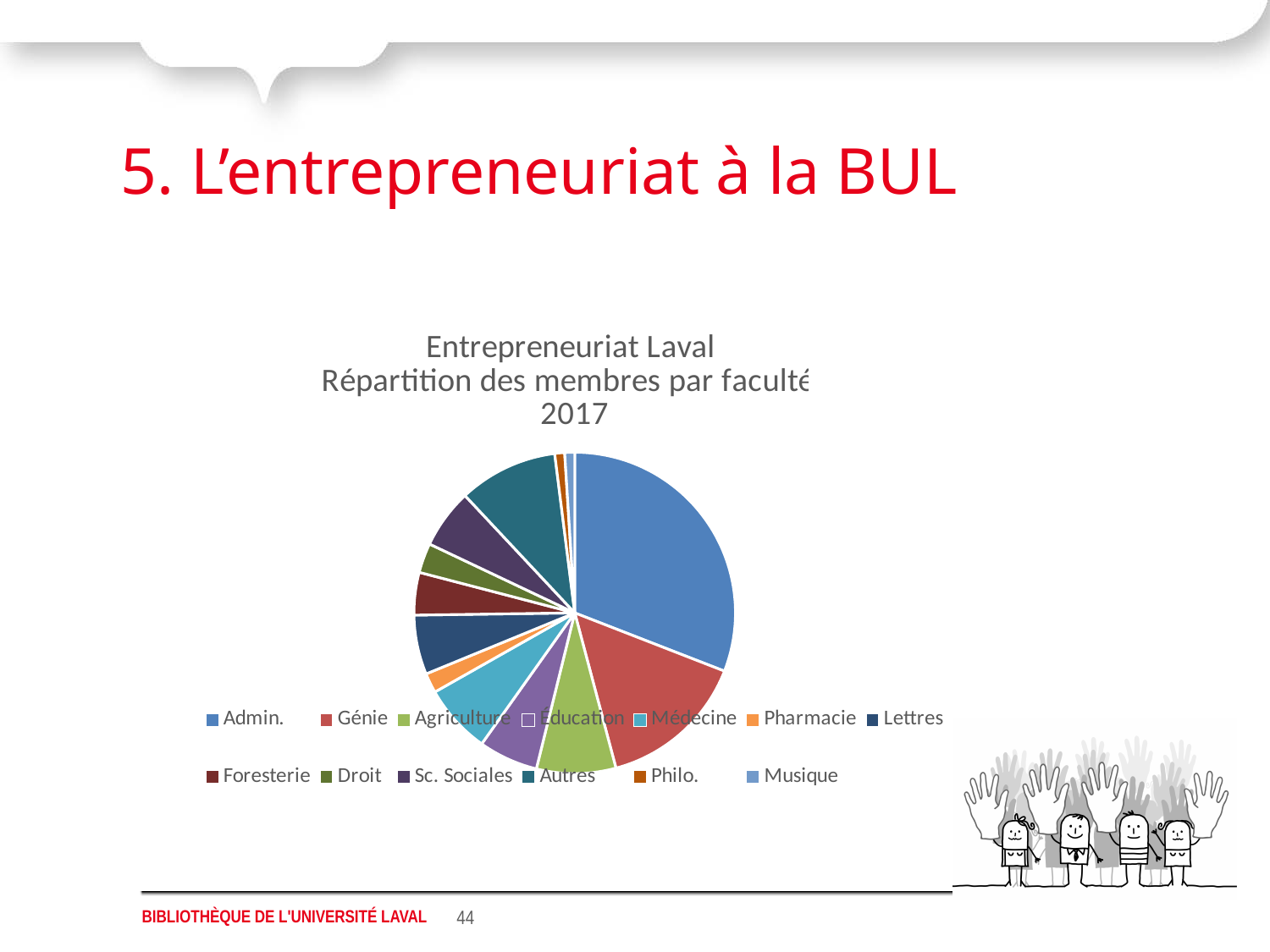
Which slice is larger, Génie or Agriculture? Génie Which slice is larger, Génie or Médecine? Génie What kind of chart is shown on the slide? pie chart What is the first line of the chart title? Entrepreneuriat Laval Which slice is larger, Autres or Droit? Autres Which faculty has the largest slice of the pie chart? Admin. How many categories does the pie chart's legend list? 13 What year is shown in the chart title? 2017